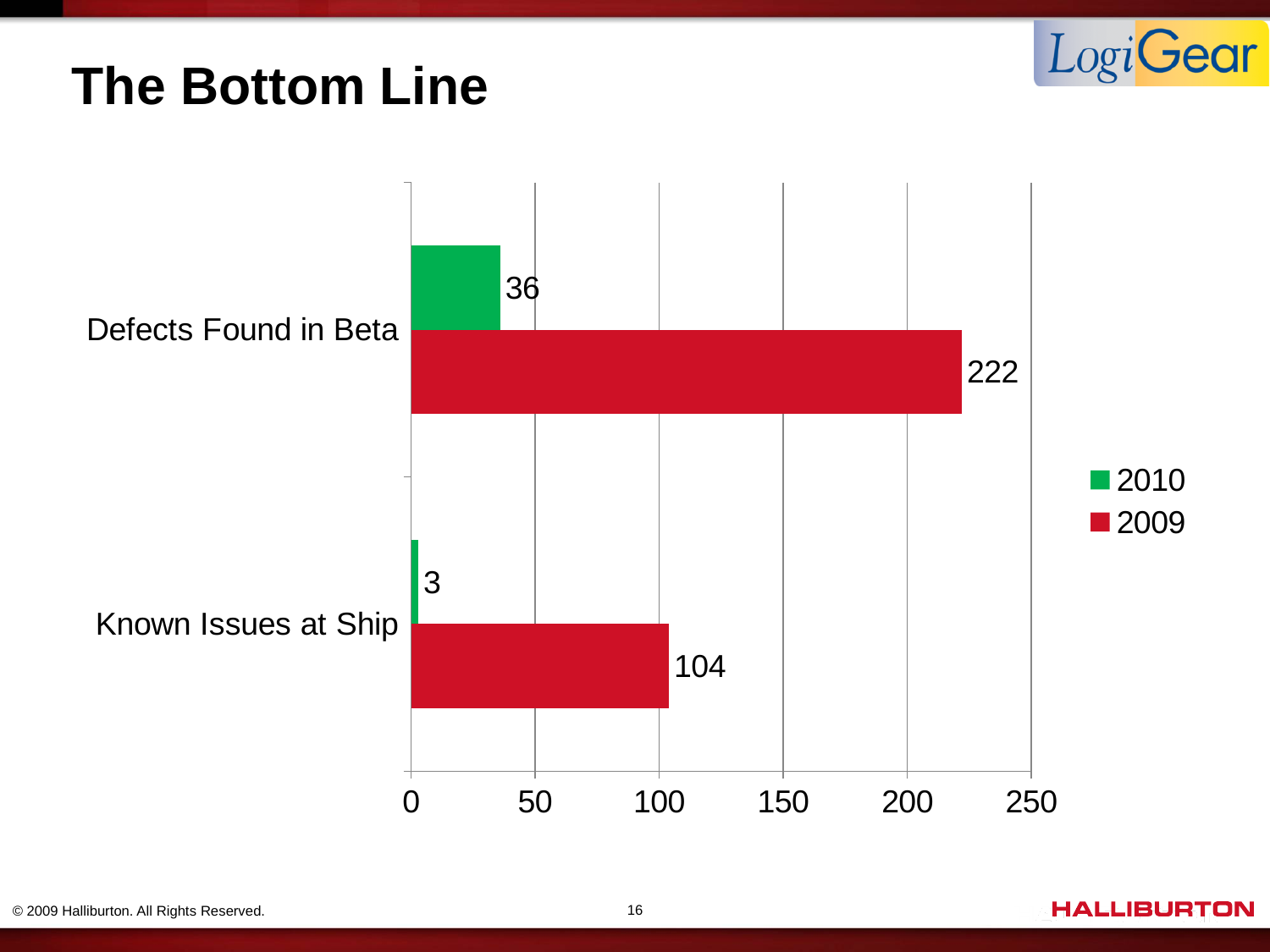
Which category has the highest 2009 value? Defects Found in Beta How many categories are shown on the chart? 2 What kind of chart is shown on the slide? Bar chart Which category has the lowest 2010 value? Known Issues at Ship What is the 2009 value for Known Issues at Ship? 104 What is the 2009 value for Defects Found in Beta? 222 What is the 2010 value for Known Issues at Ship? 3 What is the 2010 value for Defects Found in Beta? 36 Which is larger for Known Issues at Ship, the 2009 value or the 2010 value? 2009 How many series does the legend list? 2 What is the difference between the 2009 and 2010 values for Known Issues at Ship? 101 What is the difference between the 2009 and 2010 values for Defects Found in Beta? 186